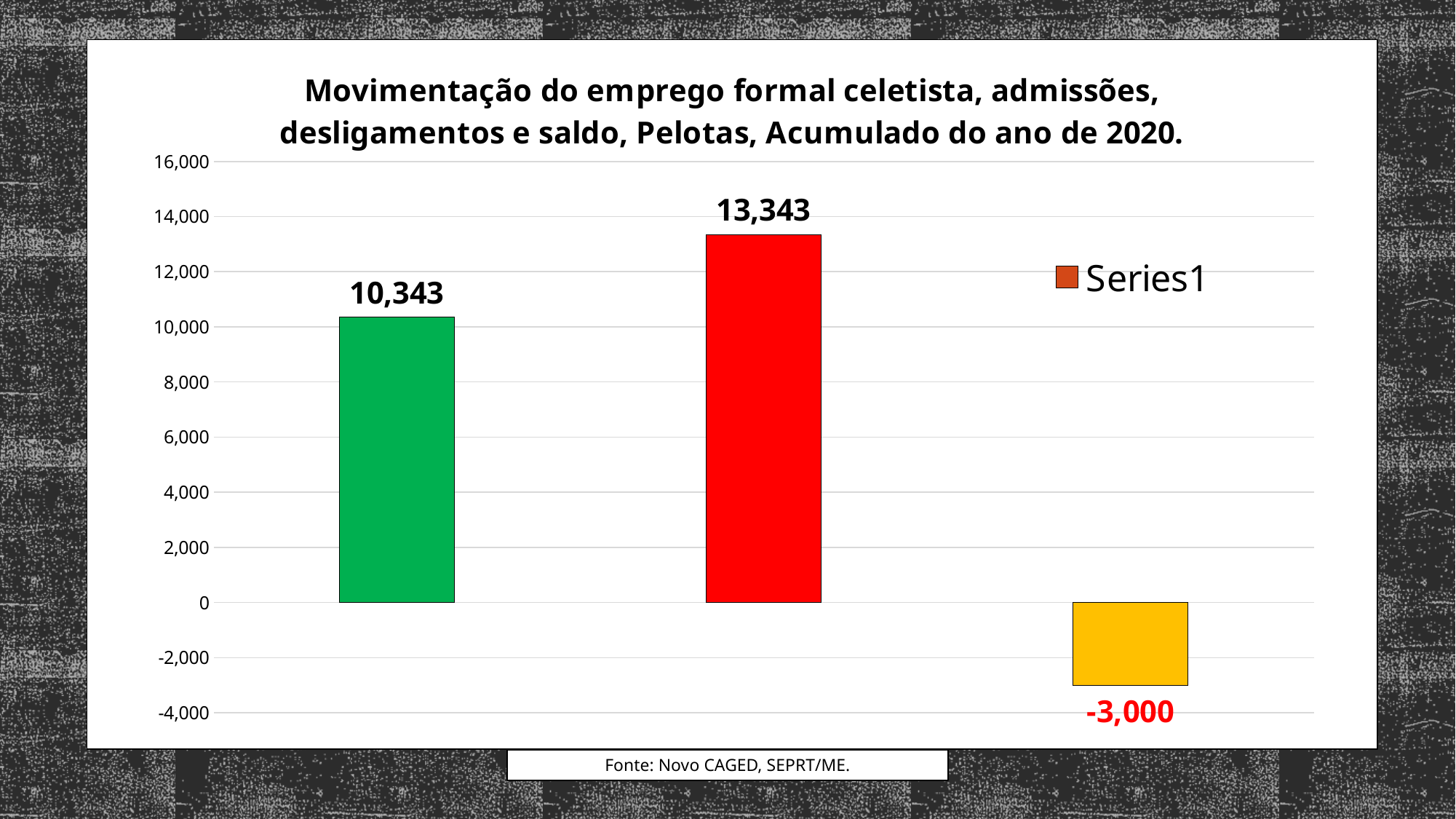
Which is larger, the value of the green bar or the value of the red bar? the red bar How many bars are plotted in the chart? 3 What is the difference between the red bar's value and the green bar's value? 3,000 What source is cited below the chart? Fonte: Novo CAGED, SEPRT/ME. What is the name of the series shown in the legend? Series1 What type of chart is shown on the slide? bar chart How many series does the legend list? 1 What is the value shown on the yellow bar (the rightmost bar)? -3,000 Which bar has the lowest value? the yellow (rightmost) bar, -3,000 Which bar has the highest value? the red (middle) bar, 13,343 What is the value shown on the red bar (the middle bar)? 13,343 What is the value shown on the green bar (the first bar from the left)? 10,343